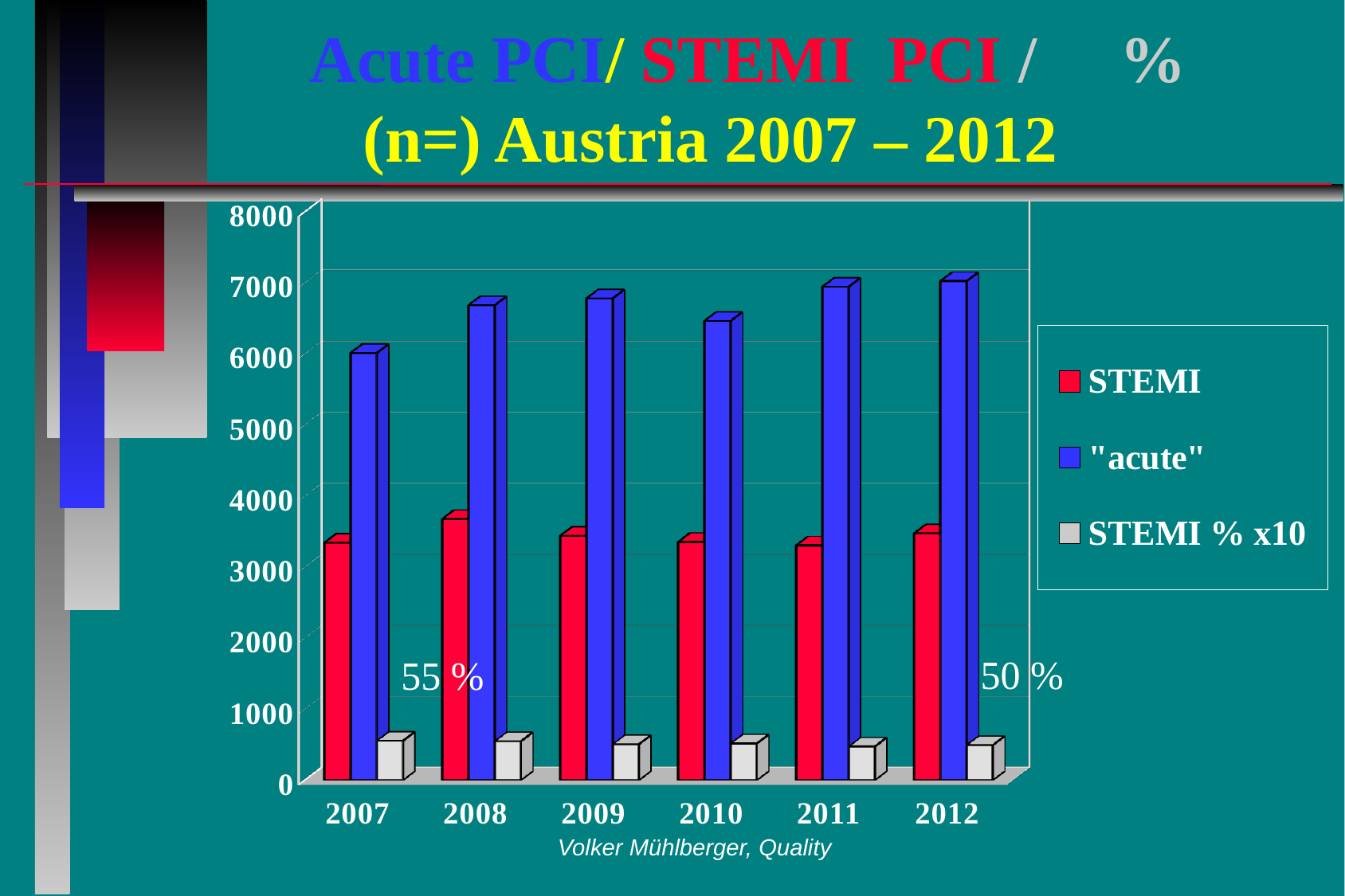
What colour are the STEMI bars? red How many years are shown on the x axis? 6 Which year has the lowest "acute" value? 2007 Is the STEMI value for 2008 greater or less than 4000? less What kind of chart is shown on the slide? bar chart Which year has the highest STEMI value? 2008 How many series does the legend list? 3 In 2007, which is larger: the STEMI value or the "acute" value? "acute" Is the "acute" value for 2007 greater or less than 5000? greater Does the "acute" series overall rise or fall from 2007 to 2012? rise Is the "acute" value for 2012 greater or less than 6000? greater